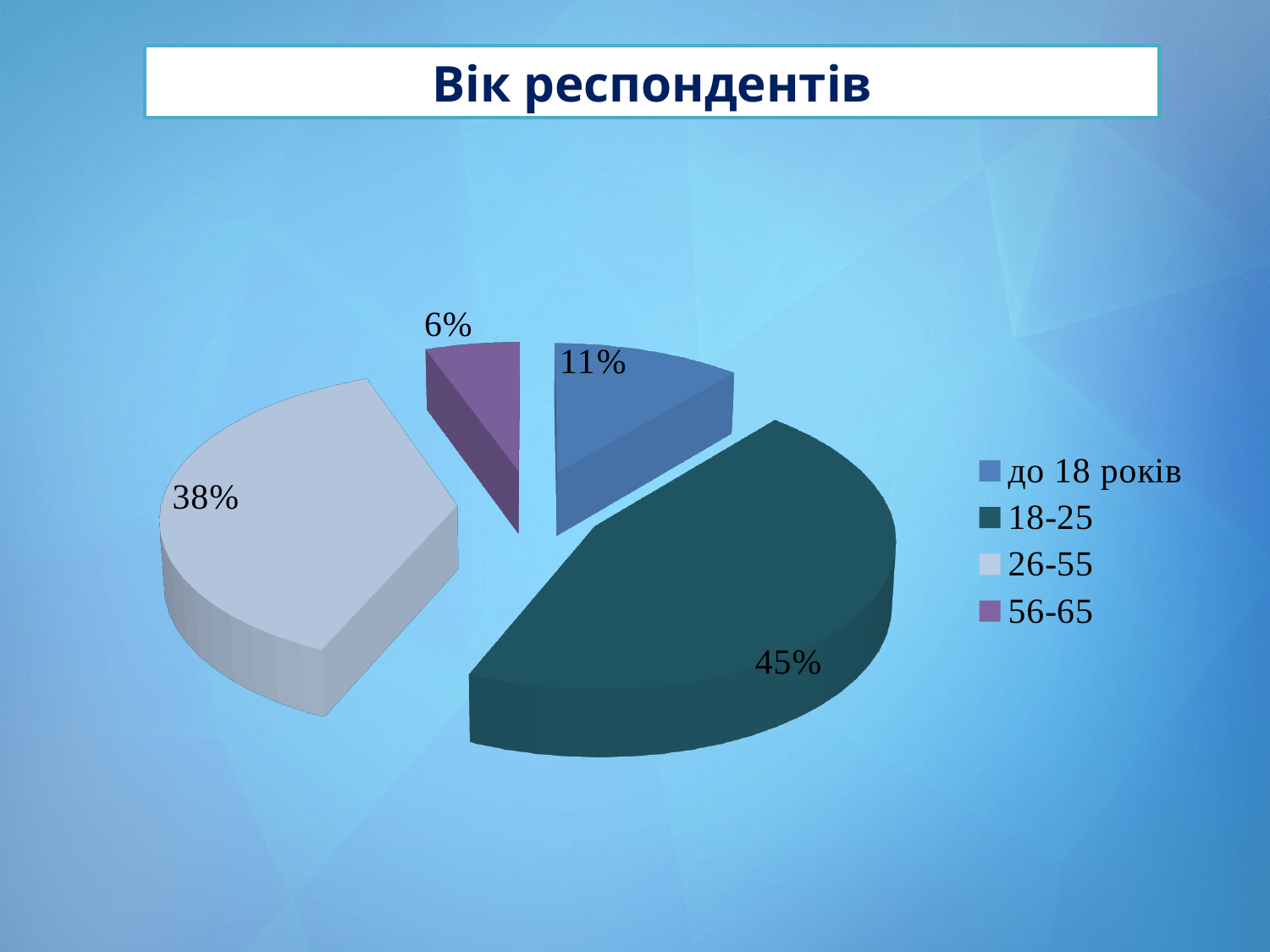
What share of respondents are aged 26-55? 38% How many age groups are shown in the pie chart? 4 What is the difference in percentage points between the under-18 group and the 56-65 group? 5 What is the title of the chart? Вік респондентів What type of chart is shown on the slide? Pie chart What share of respondents are under 18 (до 18 років)? 11% What share of respondents are aged 18-25? 45% Which age group has the smallest share of respondents? 56-65 Which group has a larger share: до 18 років or 56-65? до 18 років What share of respondents are aged 56-65? 6% Which age group has the largest share of respondents? 18-25 What is the difference in percentage points between the 18-25 and 26-55 groups? 7